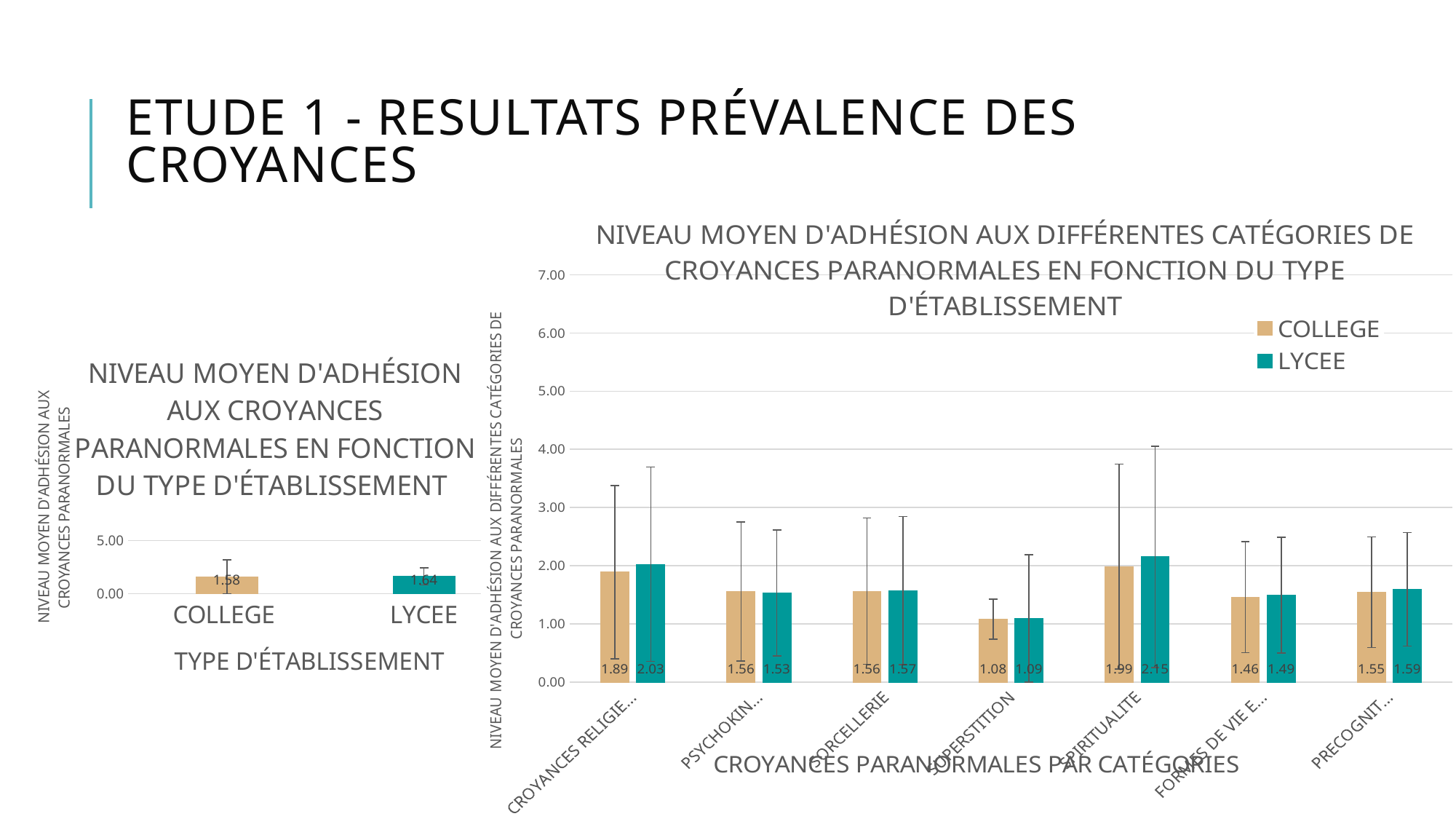
On the left chart, what is the value for COLLEGE? 1.58 On the right chart, what is the LYCEE value for SORCELLERIE? 1.57 On the right chart, what is the COLLEGE value for SUPERSTITION? 1.08 On the right chart, what is the difference between the LYCEE and COLLEGE values for SPIRITUALITE? 0.16 On the right chart, which category has the lowest LYCEE value? SUPERSTITION How many series does the legend of the right chart list? 2 On the right chart, what is the LYCEE value for SPIRITUALITE? 2.15 On the left chart, which type of establishment has the higher value, COLLEGE or LYCEE? LYCEE On the right chart, which category has the highest COLLEGE value? SPIRITUALITE How many categories are shown on the x axis of the right chart? 7 On the left chart, what is the difference between the LYCEE and COLLEGE values? 0.06 On the left chart, what is the value for LYCEE? 1.64